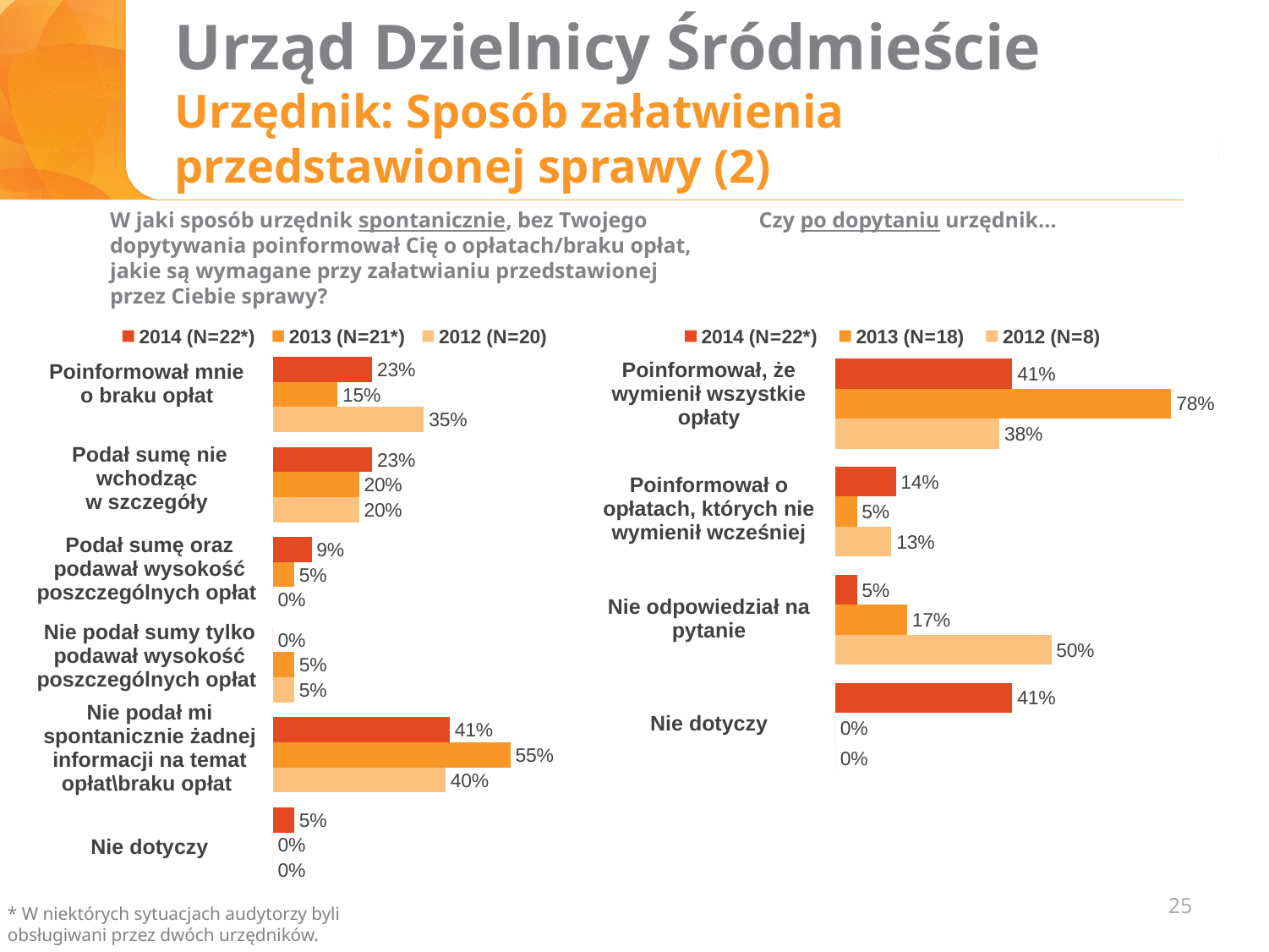
In the right chart ("Czy po dopytaniu urzędnik..."), which category has the highest 2012 value? Nie odpowiedział na pytanie How many categories does the left chart (spontaneous information about fees) show? 6 In the left chart (spontaneous information about fees), which is larger for "Poinformował mnie o braku opłat": the 2014 value or the 2013 value? 2014 How many series does the legend of the right chart ("Czy po dopytaniu urzędnik...") list? 3 What kind of chart is the left chart (spontaneous information about fees)? Bar chart In the left chart (spontaneous information about fees), what is the 2012 value for "Poinformował mnie o braku opłat"? 35% In the right chart ("Czy po dopytaniu urzędnik..."), what is the 2013 value for "Poinformował, że wymienił wszystkie opłaty"? 78% In the right chart ("Czy po dopytaniu urzędnik..."), what is the difference between the 2013 and 2014 values for "Poinformował, że wymienił wszystkie opłaty"? 37 percentage points In the right chart ("Czy po dopytaniu urzędnik..."), what sample size (N) is given for 2012 in the legend? N=8 In the left chart (spontaneous information about fees), what is the 2013 value for "Nie podał mi spontanicznie żadnej informacji na temat opłat\braku opłat"? 55% In the left chart (spontaneous information about fees), which category has the highest 2014 value? Nie podał mi spontanicznie żadnej informacji na temat opłat\braku opłat In the right chart ("Czy po dopytaniu urzędnik..."), what is the 2014 value for "Nie dotyczy"? 41%